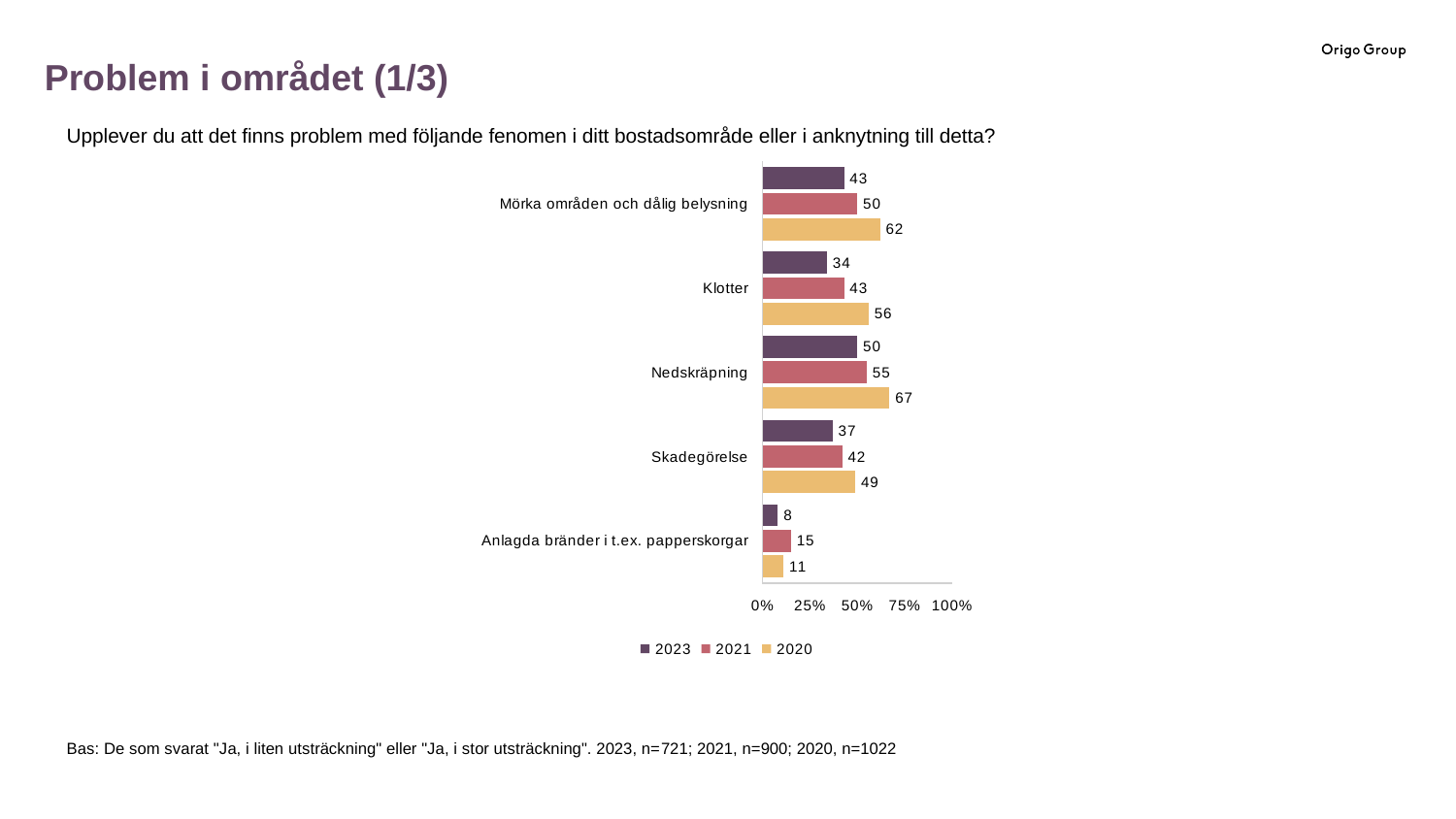
Is the 2020 value for Nedskräpning greater or less than 50%? greater What kind of chart is shown on the slide? bar chart Which is larger for Skadegörelse, the 2021 value or the 2023 value? 2021 What is the 2020 value for Klotter? 56 How many categories are shown on the chart? 5 Which category has the lowest 2023 value? Anlagda bränder i t.ex. papperskorgar What is the difference between the 2020 and 2023 values for Mörka områden och dålig belysning? 19 Which category has the highest 2020 value? Nedskräpning What is the 2023 value for Nedskräpning? 50 What is the 2021 value for Anlagda bränder i t.ex. papperskorgar? 15 Which series is shown in yellow in the legend? 2020 How many series does the legend list? 3